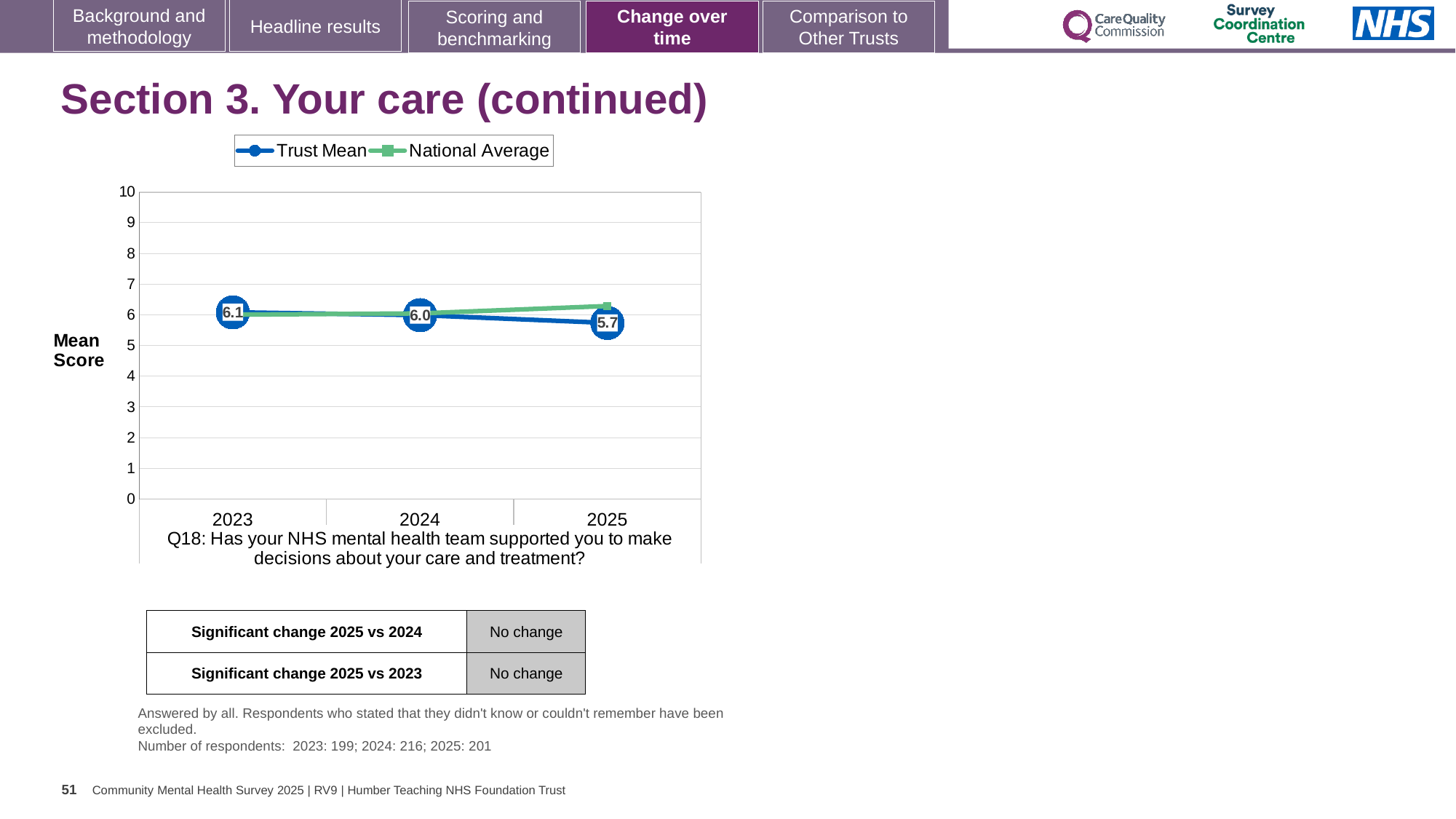
How many years are shown on the x axis of the chart? 3 What is the Trust Mean score for 2023? 6.1 In which year is the Trust Mean score highest? 2023 What is the Trust Mean score for 2025? 5.7 In 2025, which is higher: the Trust Mean or the National Average? National Average In which year is the Trust Mean score lowest? 2025 How many series does the chart legend list? 2 Does the Trust Mean score rise or fall from 2023 to 2025? Fall What is the difference between the Trust Mean score in 2023 and in 2025? 0.4 What is the Trust Mean score for 2024? 6.0 Is the National Average value for 2025 greater or less than 5? greater What kind of chart is shown on the slide? Line chart